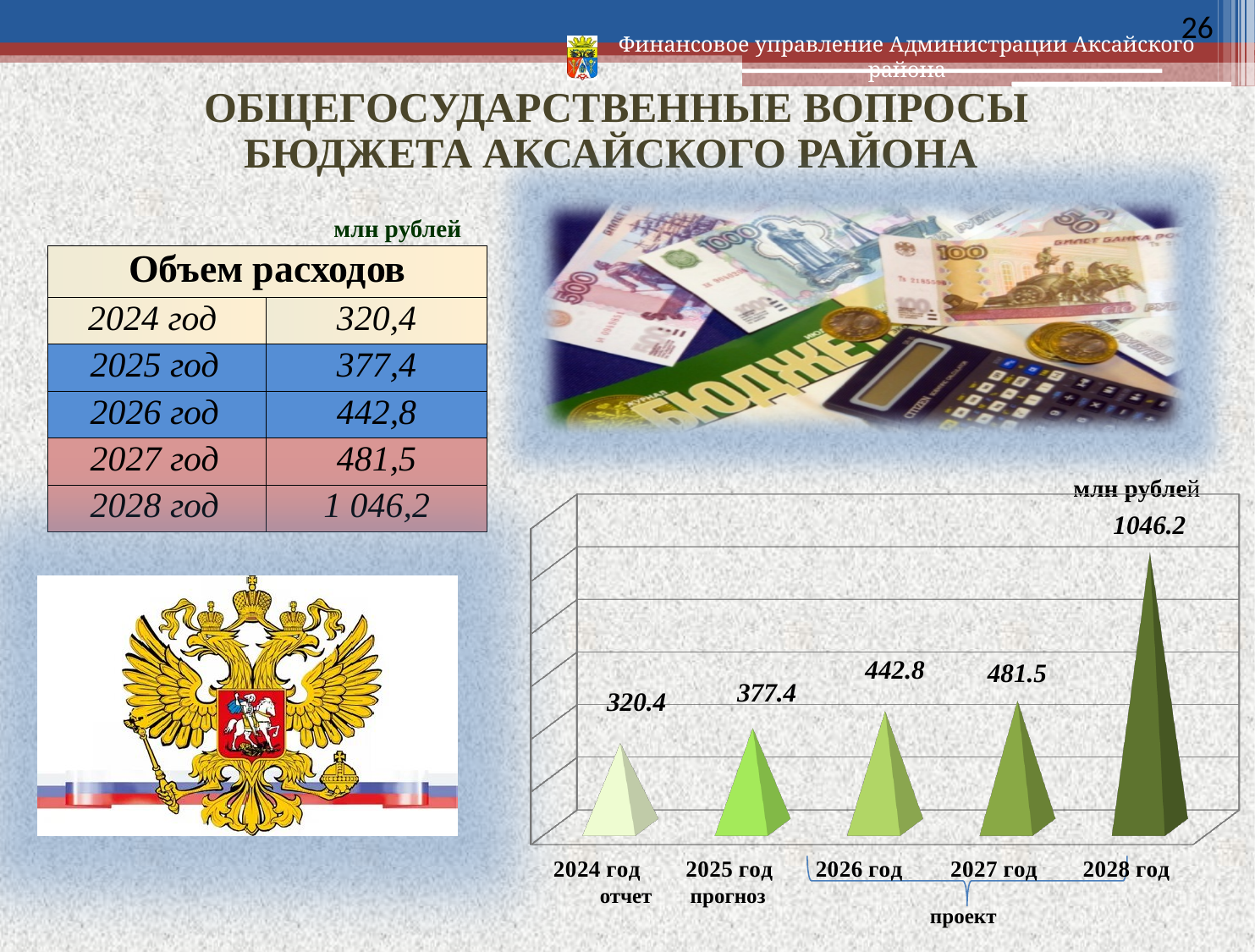
What value is shown for 2028 год on the chart? 1046.2 What value is shown for 2026 год on the chart? 442.8 How many years are plotted on the chart? 5 What value is shown for 2024 год on the chart? 320.4 Which is larger, the value for 2025 год or the value for 2027 год? 2027 год What is the difference between the values for 2028 год and 2027 год? 564.7 What kind of chart is shown on the slide? bar chart Which year has the highest value on the chart? 2028 год Which year has the lowest value on the chart? 2024 год What is the difference between the values for 2026 год and 2025 год? 65.4 What unit is indicated above the chart? млн рублей Do the values rise or fall from 2024 год to 2028 год? rise